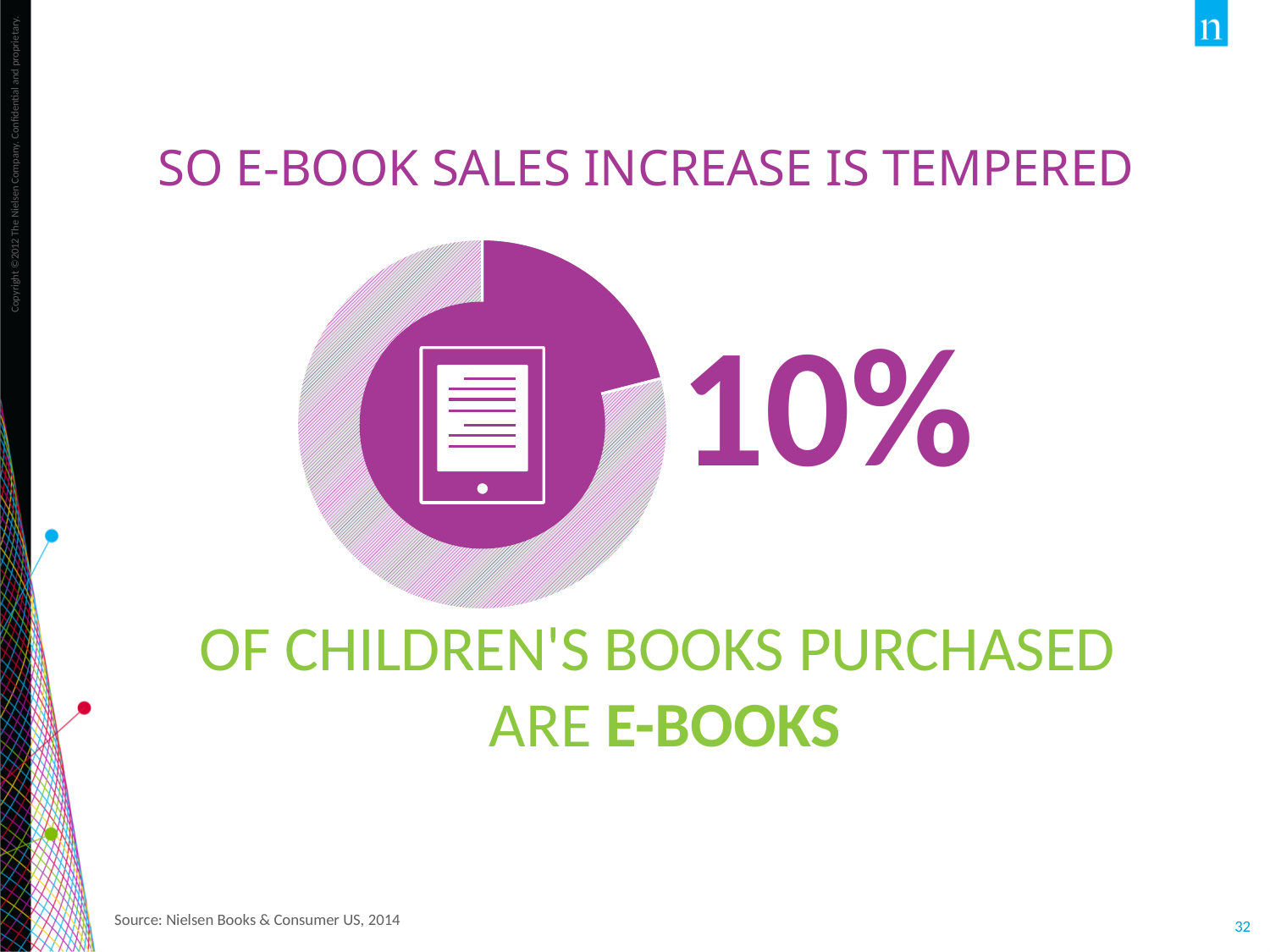
Which slice is larger: the solid purple e-books slice or the hatched slice for the remaining books? The hatched slice What is the title of the slide containing the chart? SO E-BOOK SALES INCREASE IS TEMPERED What kind of chart is shown on the slide? Doughnut chart What share of children's books purchased are not e-books, based on the value shown? 90% Is the e-books share of children's books purchased greater or less than 50%? less What percentage of children's books purchased are e-books, according to the chart? 10% What icon is shown in the centre of the pie chart? An e-reader/tablet How many slices does the pie chart have? 2